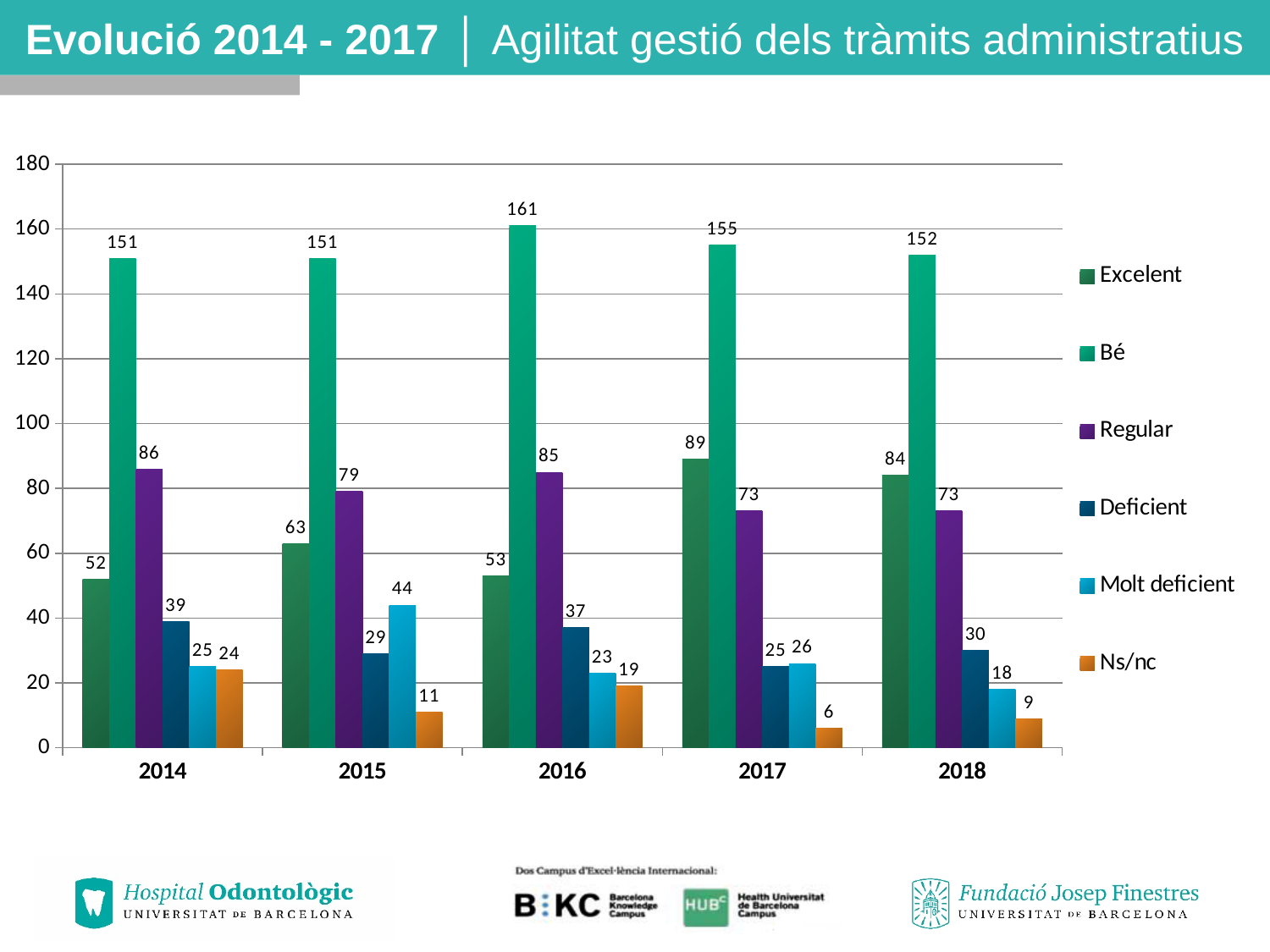
What is the value for Molt deficient in 2015? 44 What is the value for Excelent in 2017? 89 How many series does the legend list? 6 How many years are shown on the x axis? 5 Which is larger, Excelent in 2015 or Excelent in 2016? Excelent in 2015 In which year is the Ns/nc value lowest? 2017 What kind of chart is shown on the slide? Bar chart What is the value for Ns/nc in 2018? 9 What is the value for Bé in 2016? 161 In which year is the Bé value highest? 2016 Does the Ns/nc value rise or fall from 2014 to 2017? Fall What is the difference between the Regular values in 2014 and 2018? 13